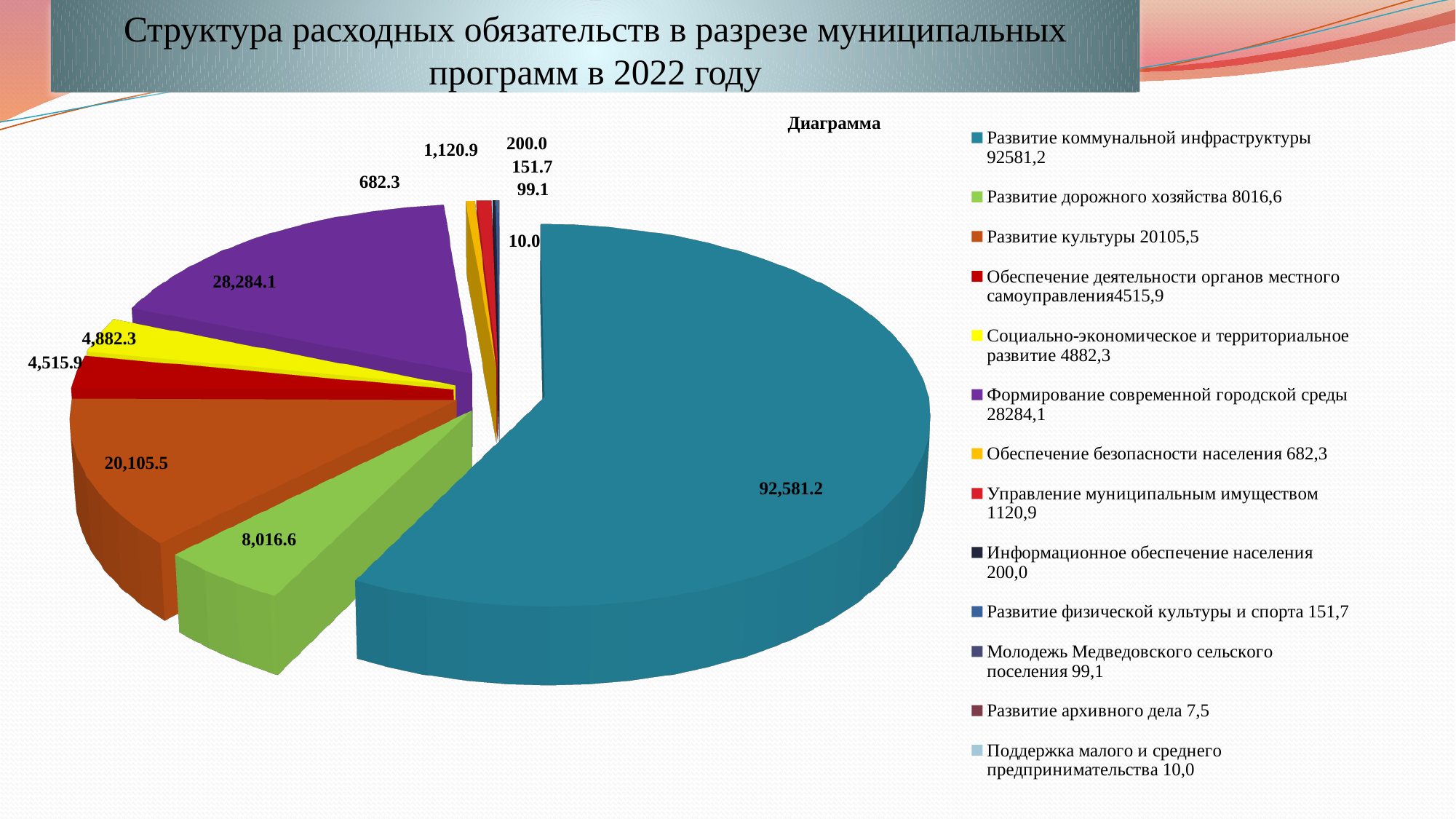
What kind of chart is shown on the slide? Pie chart What is the value for Формирование современной городской среды? 28,284.1 What is the value for Развитие дорожного хозяйства? 8,016.6 What is the title shown above the pie chart? Диаграмма What is the value for Развитие коммунальной инфраструктуры? 92,581.2 What is the difference between the values for Социально-экономическое и территориальное развитие and Обеспечение деятельности органов местного самоуправления? 366.4 What is the value for Обеспечение безопасности населения? 682.3 Which category has the largest slice of the pie? Развитие коммунальной инфраструктуры How many categories does the legend list? 13 What is the difference between the values for Формирование современной городской среды and Развитие культуры? 8,178.6 Which is larger: the value for Развитие культуры or the value for Развитие дорожного хозяйства? Развитие культуры Which category has the smallest value listed in the legend? Развитие архивного дела